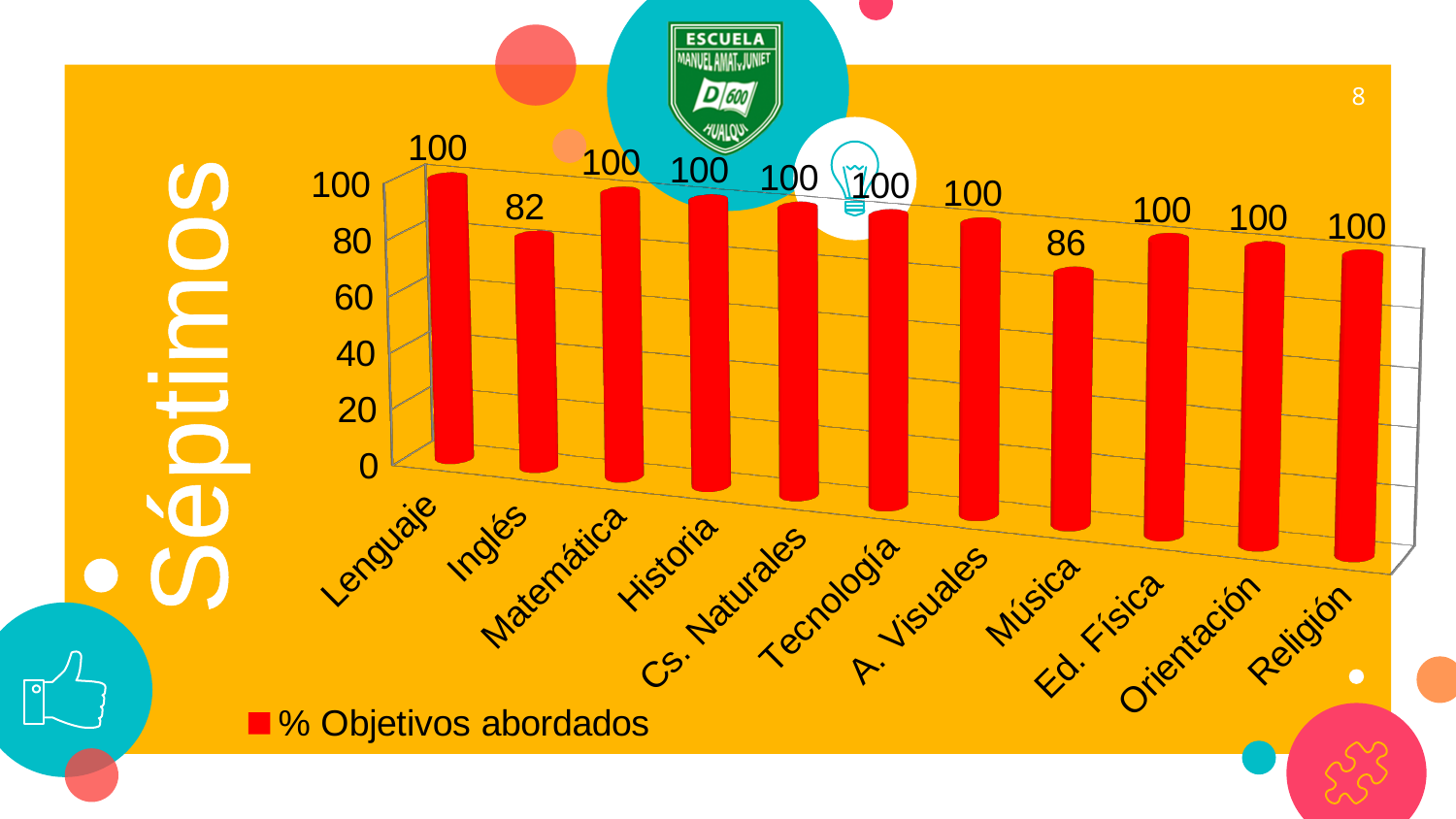
What is the value for Música? 86 What kind of chart is shown on the slide? Bar chart Which is larger, the value for Música or the value for Inglés? Música What is the difference between the values for Lenguaje and Inglés? 18 What is the value for Inglés? 82 Which category has the lowest value? Inglés What is the difference between the values for Música and Inglés? 4 Which is larger, the value for Historia or the value for Música? Historia What is the value for Religión? 100 How many categories are shown on the x axis? 11 What is the legend entry for the series shown? % Objetivos abordados What is the value for Lenguaje? 100